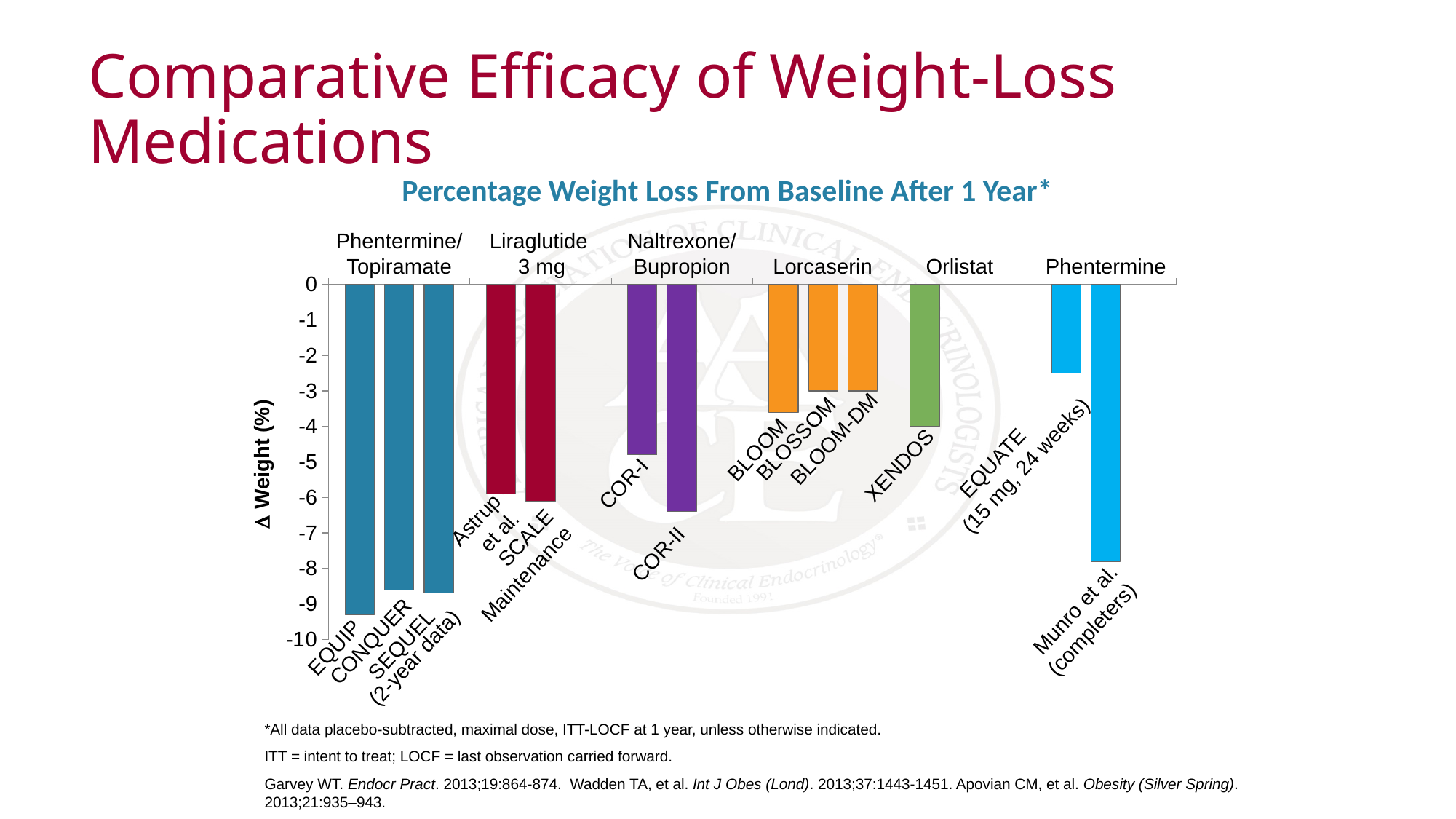
How many bars (trials) are plotted in the chart? 13 Is the value for Munro et al. (completers) greater or less than -7? less What kind of chart is shown on the slide? bar chart Which trial shows the smallest percentage weight loss (the shortest bar)? EQUATE (15 mg, 24 weeks) Which trial shows a larger weight loss, COR-I or COR-II? COR-II Is the value for Astrup et al. greater or less than -5? less Is the value for BLOOM greater or less than -4? greater What is the title of the chart? Percentage Weight Loss From Baseline After 1 Year* Which trial shows the greatest percentage weight loss (the longest bar)? EQUIP How many medication groups are labeled across the top of the chart? 6 What is the label of the y axis? Δ Weight (%)